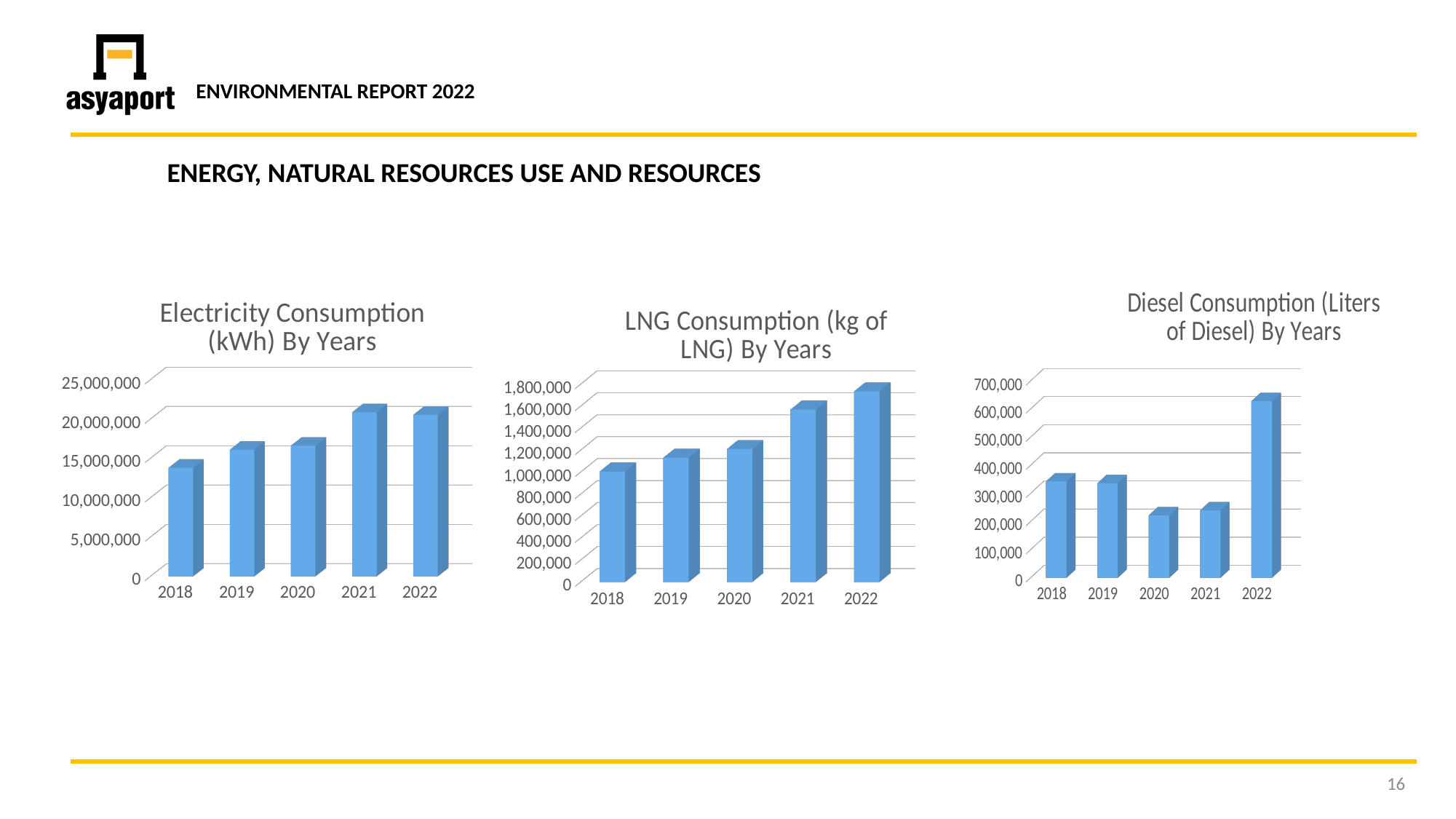
In the Electricity Consumption (kWh) By Years chart, which year has the lowest value? 2018 In the LNG Consumption (kg of LNG) By Years chart, which year has the lowest value? 2018 How many years are shown on the LNG Consumption (kg of LNG) By Years chart? 5 In the LNG Consumption (kg of LNG) By Years chart, do the values rise or fall from 2018 to 2022? rise In the Electricity Consumption (kWh) By Years chart, is the value for 2022 greater or less than 15,000,000? greater In the Diesel Consumption (Liters of Diesel) By Years chart, which year has the highest value? 2022 In the Diesel Consumption (Liters of Diesel) By Years chart, is the value for 2020 greater or less than 300,000? less In the LNG Consumption (kg of LNG) By Years chart, is the value for 2022 greater or less than 1,600,000? greater In the LNG Consumption (kg of LNG) By Years chart, which year has the highest value? 2022 In the Diesel Consumption (Liters of Diesel) By Years chart, which is larger, the value for 2018 or the value for 2021? 2018 What kind of chart is the Electricity Consumption (kWh) By Years chart? bar chart